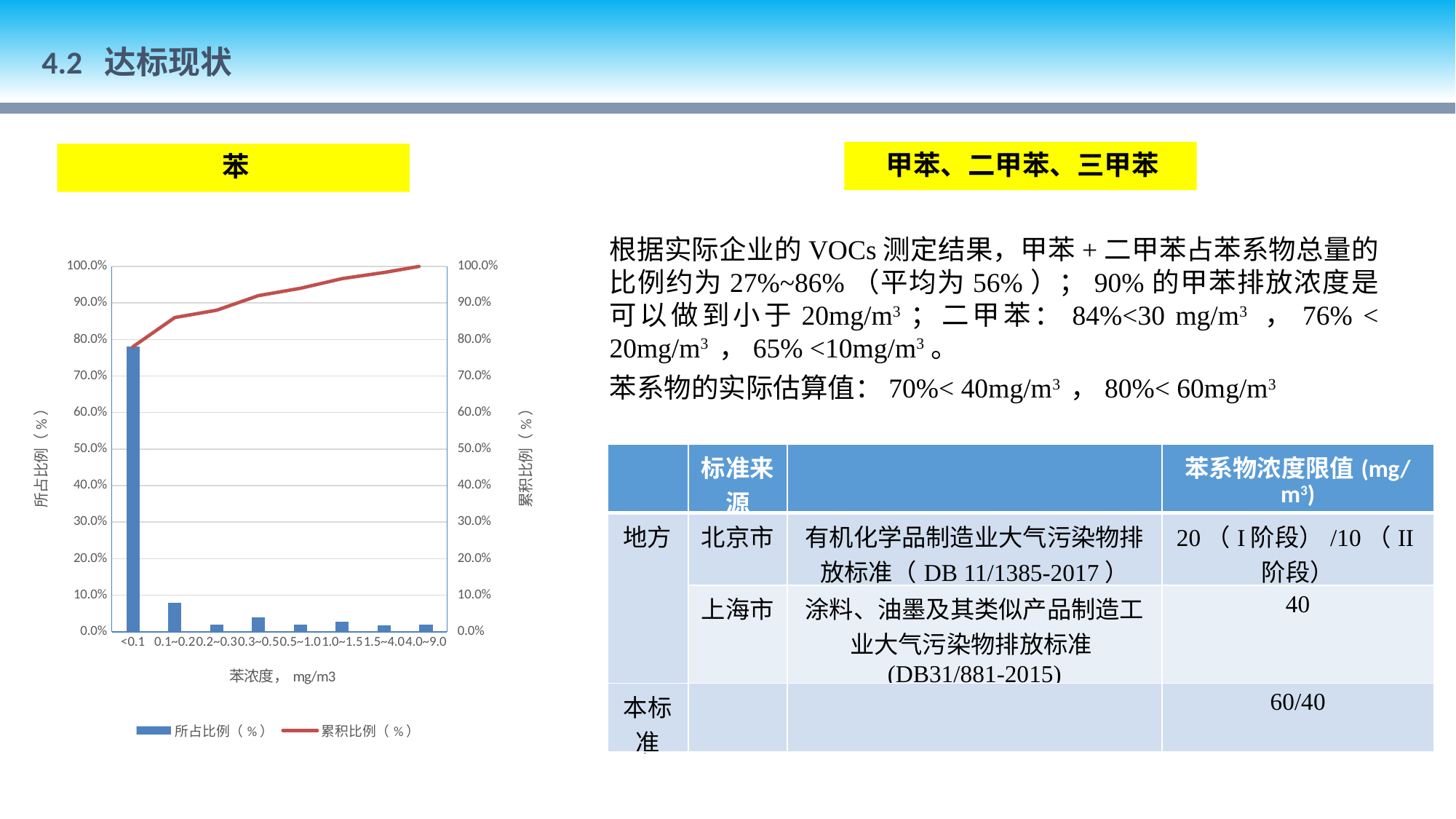
Which concentration category has the highest 所占比例 bar? <0.1 How many concentration categories are shown on the x axis of the chart? 8 Is the 累积比例 value for the 0.1~0.2 category greater or less than 80%? greater Which has the larger 所占比例 bar, 0.1~0.2 or 0.3~0.5? 0.1~0.2 Does the 累积比例 line rise or fall as concentration increases along the x axis? rises What kind of chart is shown on the left of the slide? bar and line chart Is the 所占比例 value for the <0.1 category greater or less than 70%? greater How many series does the chart's legend list? 2 What are the two legend entries of the chart? 所占比例（%）and 累积比例（%） Is the 所占比例 value for the 0.1~0.2 category greater or less than 10%? less What is the x-axis title of the chart? 苯浓度，mg/m3